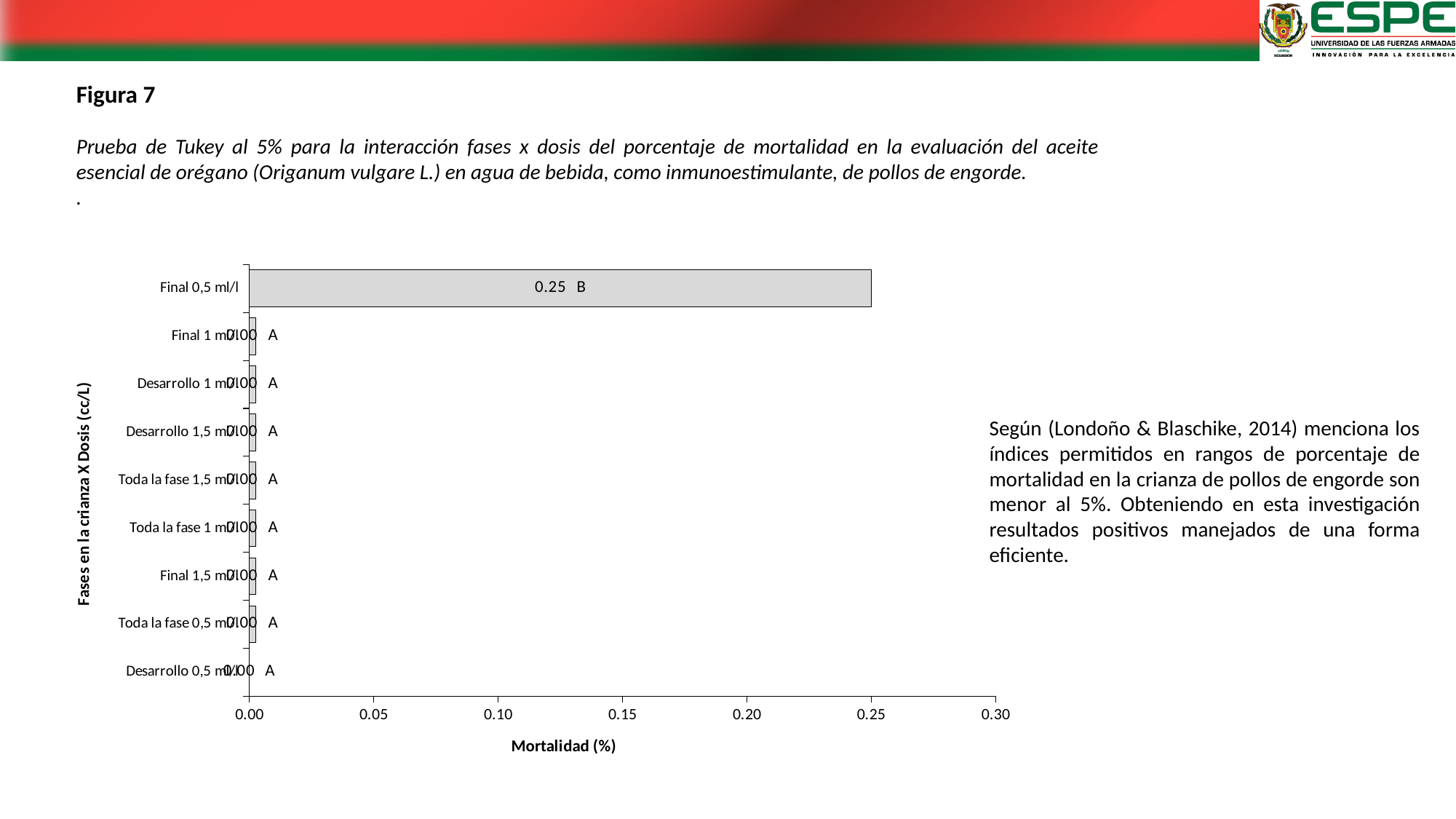
Is the value for Final 0,5 ml/l greater or less than 0.20? greater What is the difference between the values for Final 0,5 ml/l and Desarrollo 0,5 ml/l? 0.25 How many categories are plotted on the chart? 9 What is the mortality value for Desarrollo 0,5 ml/l? 0.00 What kind of chart is shown on the slide? bar chart Which Tukey group letter is shown next to the bar for Final 0,5 ml/l? B What is the mortality value for Toda la fase 0,5 ml/l? 0.00 How many categories have a value of 0.00? 8 What is the mortality value for Final 0,5 ml/l? 0.25 What is the title of the horizontal axis? Mortalidad (%) Which category has the highest mortality value? Final 0,5 ml/l Which has a larger value, Final 0,5 ml/l or Toda la fase 1 ml/l? Final 0,5 ml/l